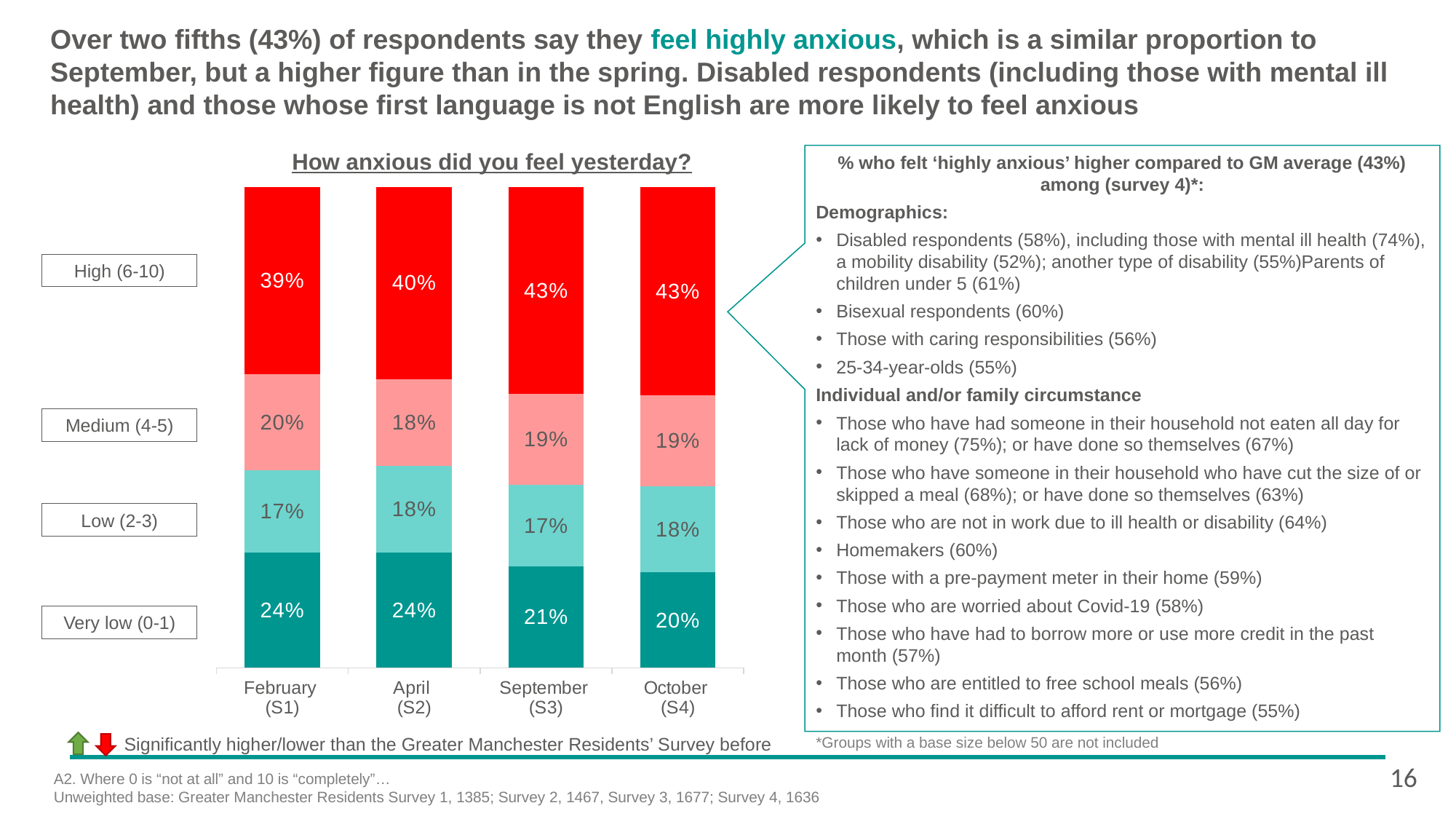
What percentage of respondents reported Very low (0-1) anxiety in February (S1)? 24% What percentage of respondents reported Medium (4-5) anxiety in April (S2)? 18% Does the High (6-10) percentage rise or fall from February (S1) to September (S3)? Rise How many survey waves are shown on the x axis of the chart? 4 What is the difference in the High (6-10) percentage between October (S4) and February (S1)? 4 percentage points Which survey wave has the lowest percentage for Very low (0-1) anxiety? October (S4) What percentage of respondents reported Low (2-3) anxiety in September (S3)? 17% Which survey wave has the lowest percentage for High (6-10) anxiety? February (S1) What percentage of respondents reported High (6-10) anxiety in October (S4)? 43% How many anxiety categories (series) are stacked in each bar? 4 Is the Very low (0-1) percentage larger in April (S2) or in September (S3)? April (S2) What type of chart is shown under the title "How anxious did you feel yesterday?"? Stacked bar chart